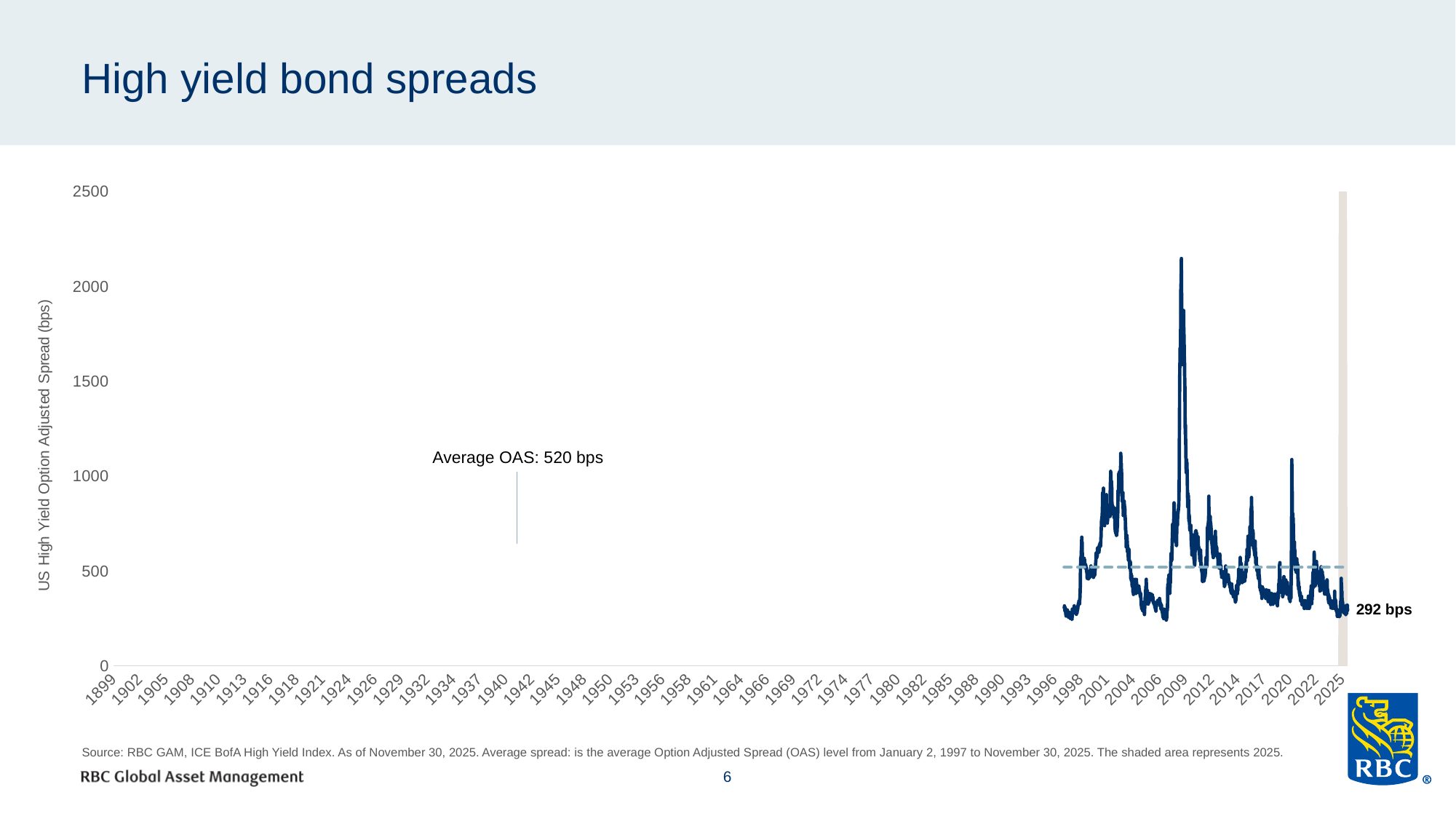
Is the peak of the spread around 2020 greater or less than 500? greater Is the highest peak of the spread, around 2009, greater or less than 2000? greater What is the highest value shown on the y axis? 2500 Which is larger, the average OAS or the latest spread of 292 bps? Average OAS What is the average OAS shown on the chart? 520 bps What is the most recent value of the US high yield option adjusted spread labelled on the chart? 292 bps By how many bps is the average OAS above the latest spread of 292 bps? 228 bps What kind of chart is shown on the slide? line chart Around which year on the x axis does the spread reach its highest peak? 2009 Is the latest spread value of 292 bps greater or less than 500? less What is the label of the y axis? US High Yield Option Adjusted Spread (bps) From the 2009 peak to 2025, does the spread generally rise or fall? fall